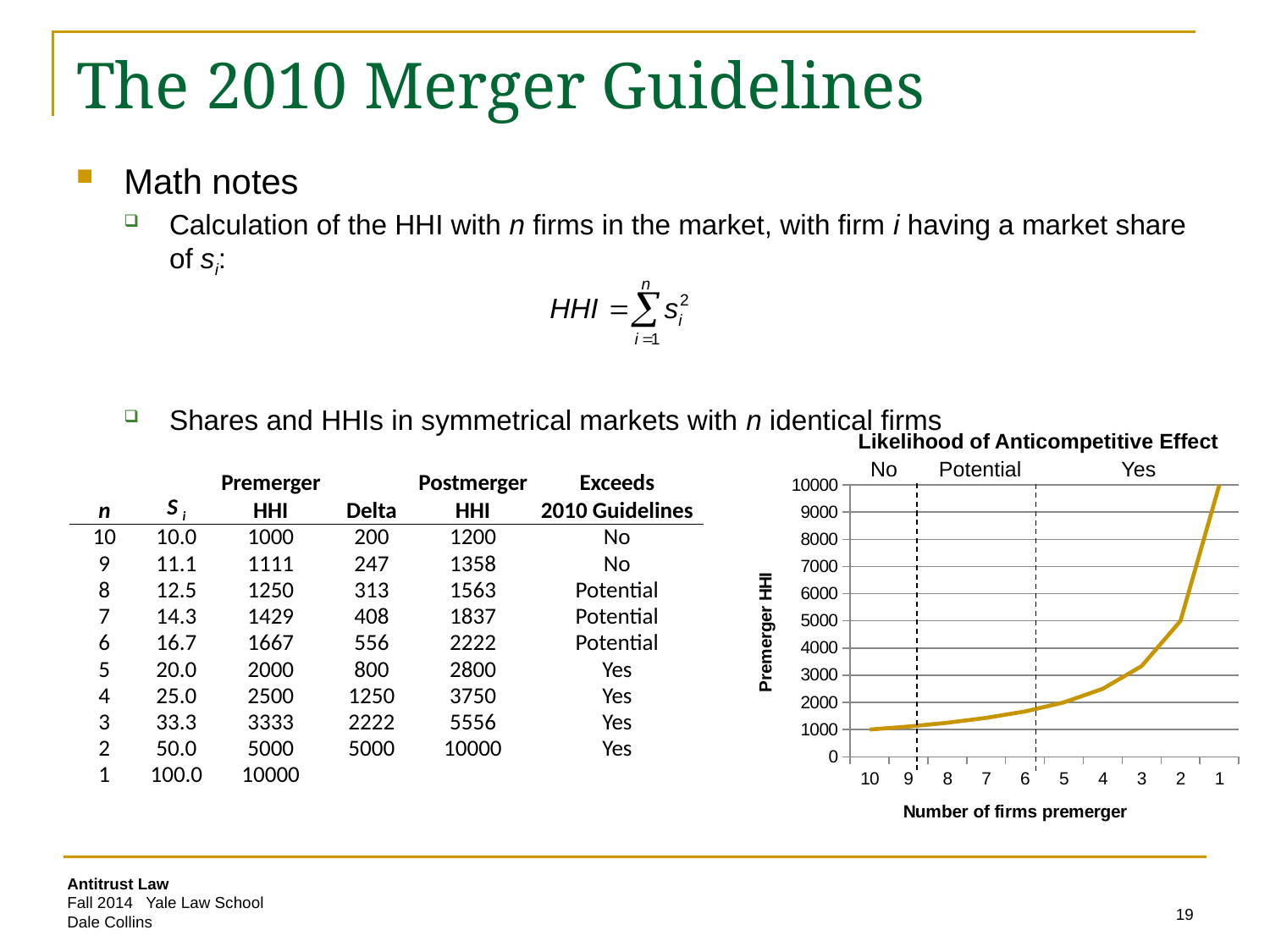
At which number of firms premerger is the Premerger HHI highest in the chart? 1 Is the Premerger HHI for 7 firms premerger greater or less than 2000? less Is the Premerger HHI for 3 firms premerger greater or less than 3000? greater What kind of chart is shown on the slide? line chart What is the Premerger HHI when the number of firms premerger is 1? 10000 What is the Premerger HHI when the number of firms premerger is 10? 1000 At which number of firms premerger is the Premerger HHI lowest in the chart? 10 How many points are plotted on the line in the chart? 10 What is the Premerger HHI when the number of firms premerger is 2? 5000 What is the title of the chart? Likelihood of Anticompetitive Effect Does the Premerger HHI rise or fall moving left to right along the x axis from 10 firms to 1 firm? rise What is the label of the vertical axis of the chart? Premerger HHI